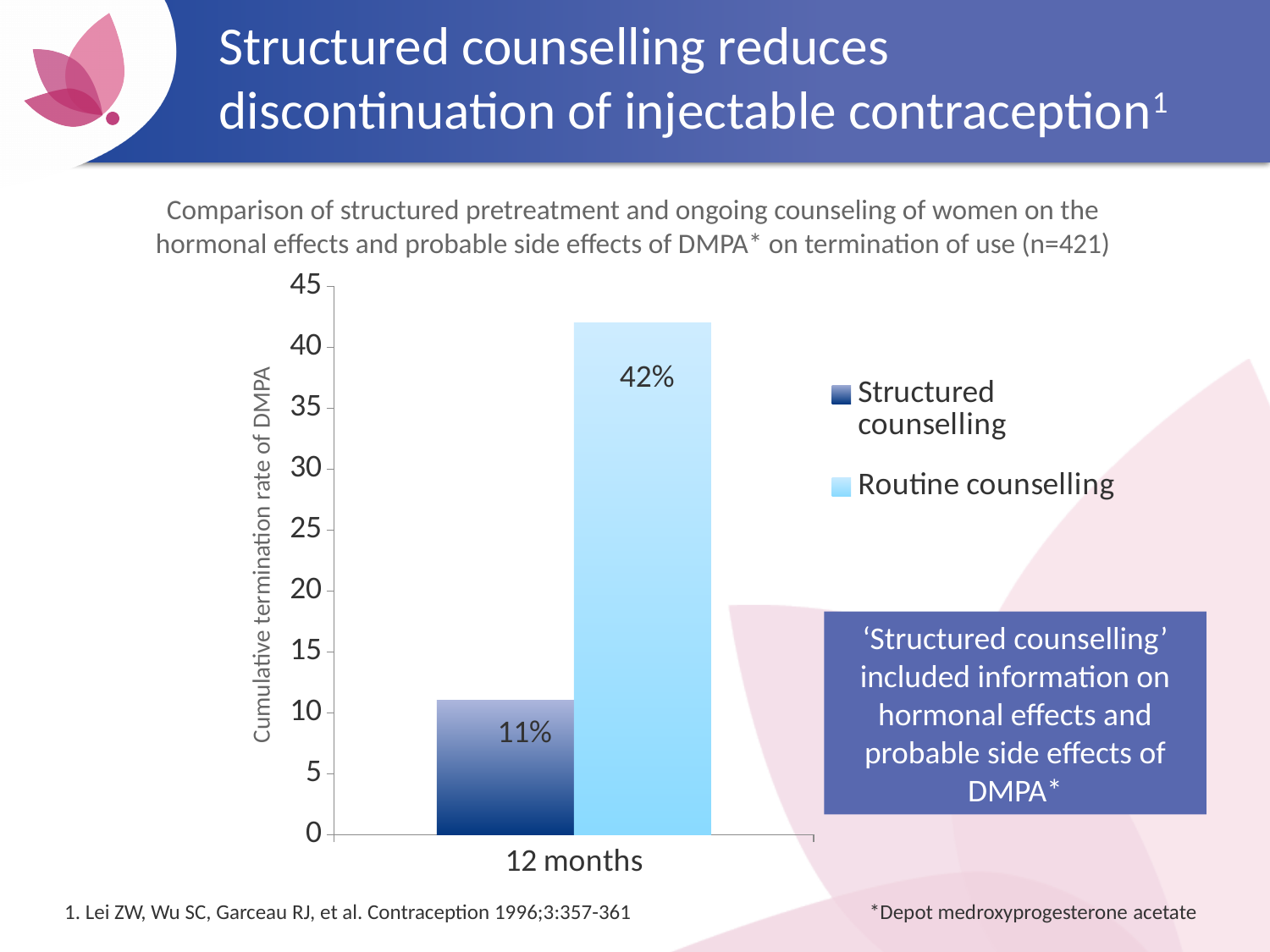
How many series does the legend list? 2 Is the value for Structured counselling greater or less than 15? less What is the label of the y axis? Cumulative termination rate of DMPA Is the termination rate for Structured counselling larger or smaller than that for Routine counselling? smaller What is the cumulative termination rate for Structured counselling at 12 months? 11% Which series has the lower termination rate at 12 months? Structured counselling Is the value for Routine counselling greater or less than 40? greater How many categories are shown on the x axis? 1 What kind of chart is shown on the slide? bar chart What is the difference in termination rate between Routine counselling and Structured counselling? 31% What is the cumulative termination rate for Routine counselling at 12 months? 42% Which series has the higher termination rate at 12 months? Routine counselling